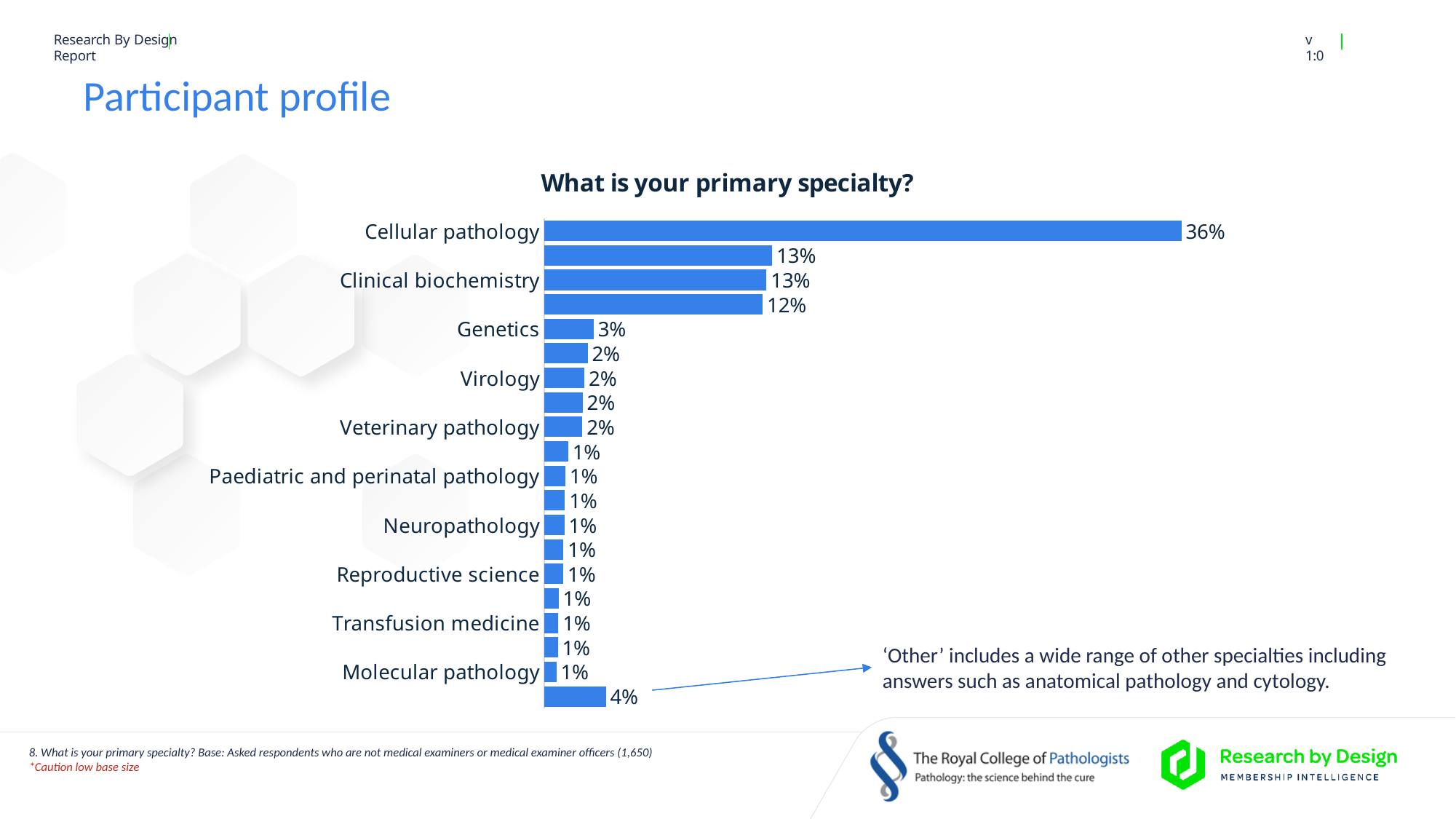
What percentage is shown for Molecular pathology? 1% How many percentage points higher is Cellular pathology than Clinical biochemistry? 23 percentage points What kind of chart is shown on the slide? Bar chart What percentage is shown for Genetics? 3% What is the value shown for Clinical biochemistry? 13% What percentage of respondents gave Cellular pathology as their primary specialty? 36% What is the difference between the values for Genetics and Veterinary pathology? 1 percentage point Which has a larger value, Genetics or Virology? Genetics What is the value for Virology? 2% Which specialty has the highest percentage of respondents? Cellular pathology How many bars are plotted in the chart? 20 What is the title of the chart? What is your primary specialty?